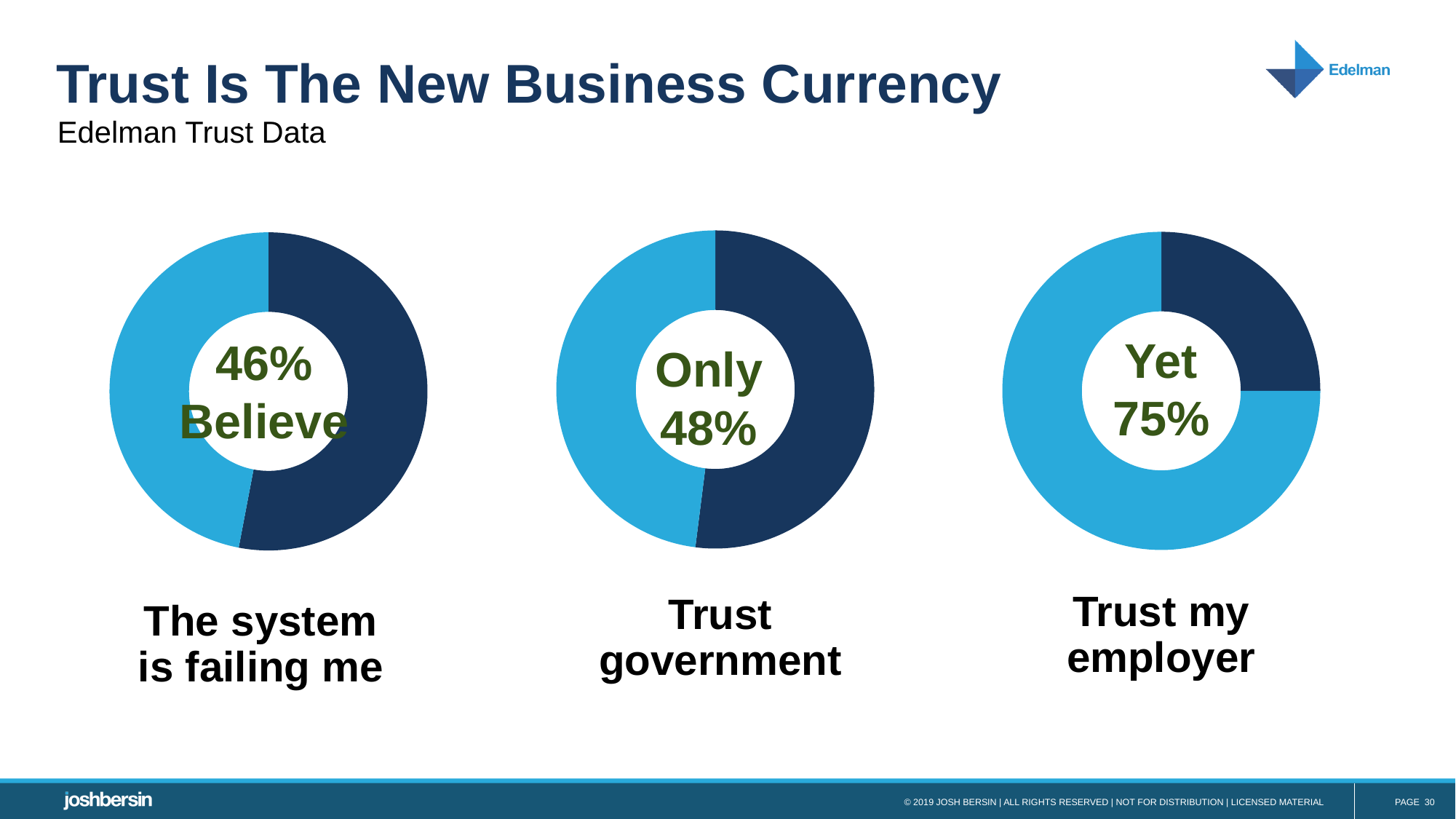
What percentage is shown in the centre of the 'Trust my employer' donut chart? 75% What is the difference between the percentage for 'Trust my employer' and the percentage for 'Trust government'? 27% Which is larger: the percentage for 'Trust my employer' or the percentage for 'Trust government'? Trust my employer Which of the three donut charts shows the lowest percentage? The system is failing me What percentage is shown in the centre of the 'Trust government' donut chart? 48% What kind of chart is used to show the trust percentages on this slide? Donut (pie) chart What percentage is shown in the centre of the 'The system is failing me' donut chart? 46% What is the title of the slide containing the three donut charts? Trust Is The New Business Currency Which of the three donut charts shows the highest percentage? Trust my employer What is the data source named in the subtitle beneath the slide title? Edelman Trust Data What is the difference between the percentage for 'Trust my employer' and the percentage for 'The system is failing me'? 29% How many donut charts are shown on the slide? 3